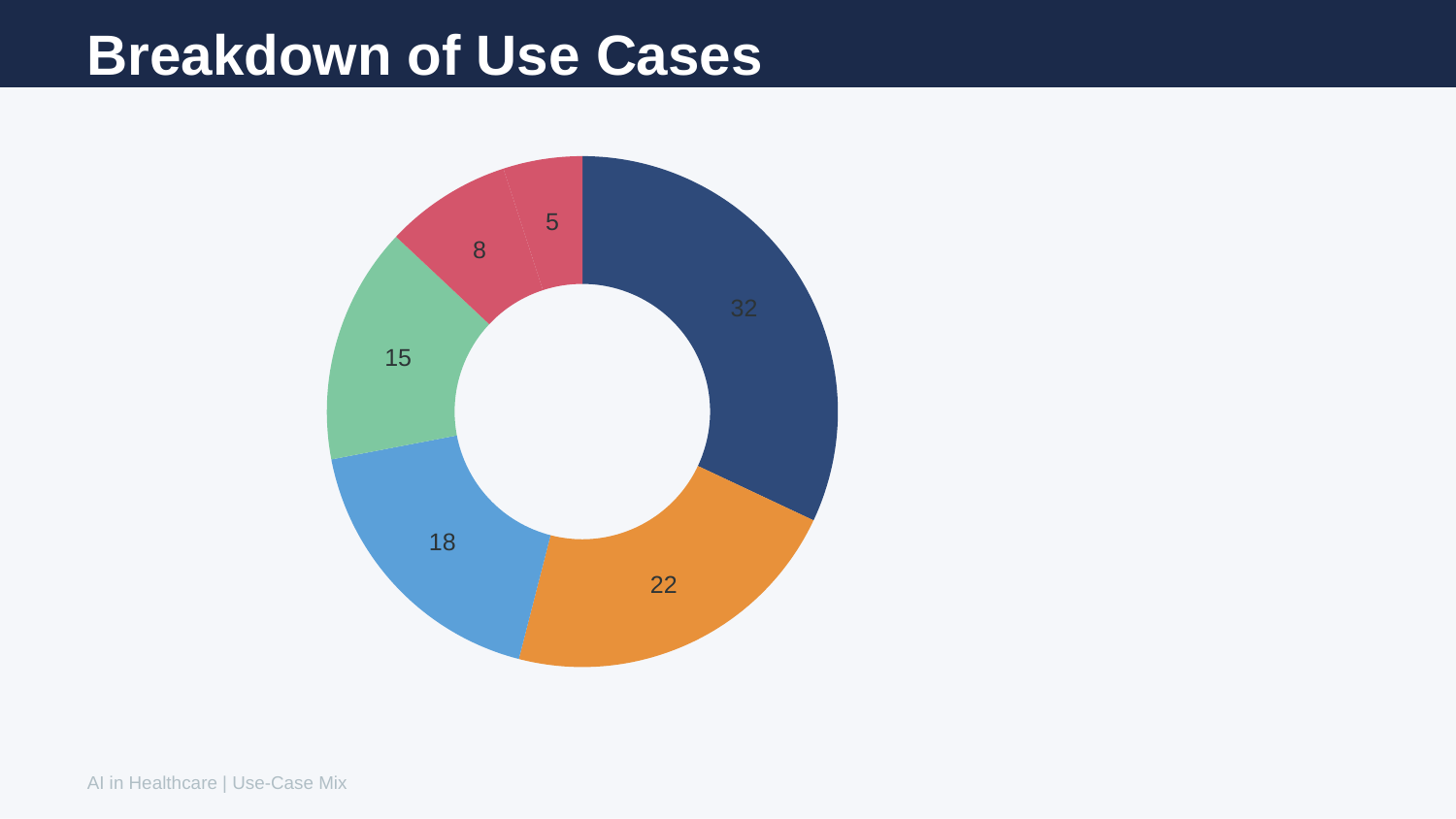
What is the smallest value shown on the donut chart? 5 How many slices does the donut chart have? 6 What value is labelled on the dark blue slice? 32 What is the title of the chart slide? Breakdown of Use Cases What value is labelled on the orange slice? 22 What is the difference between the dark blue slice (32) and the orange slice (22)? 10 Which slice is larger, the light blue slice or the green slice? light blue slice What is the largest value shown on the donut chart? 32 What value is labelled on the light blue slice? 18 What is the sum of all the slice values on the donut chart? 100 What value is labelled on the green slice? 15 What kind of chart is shown on the slide? donut (pie) chart